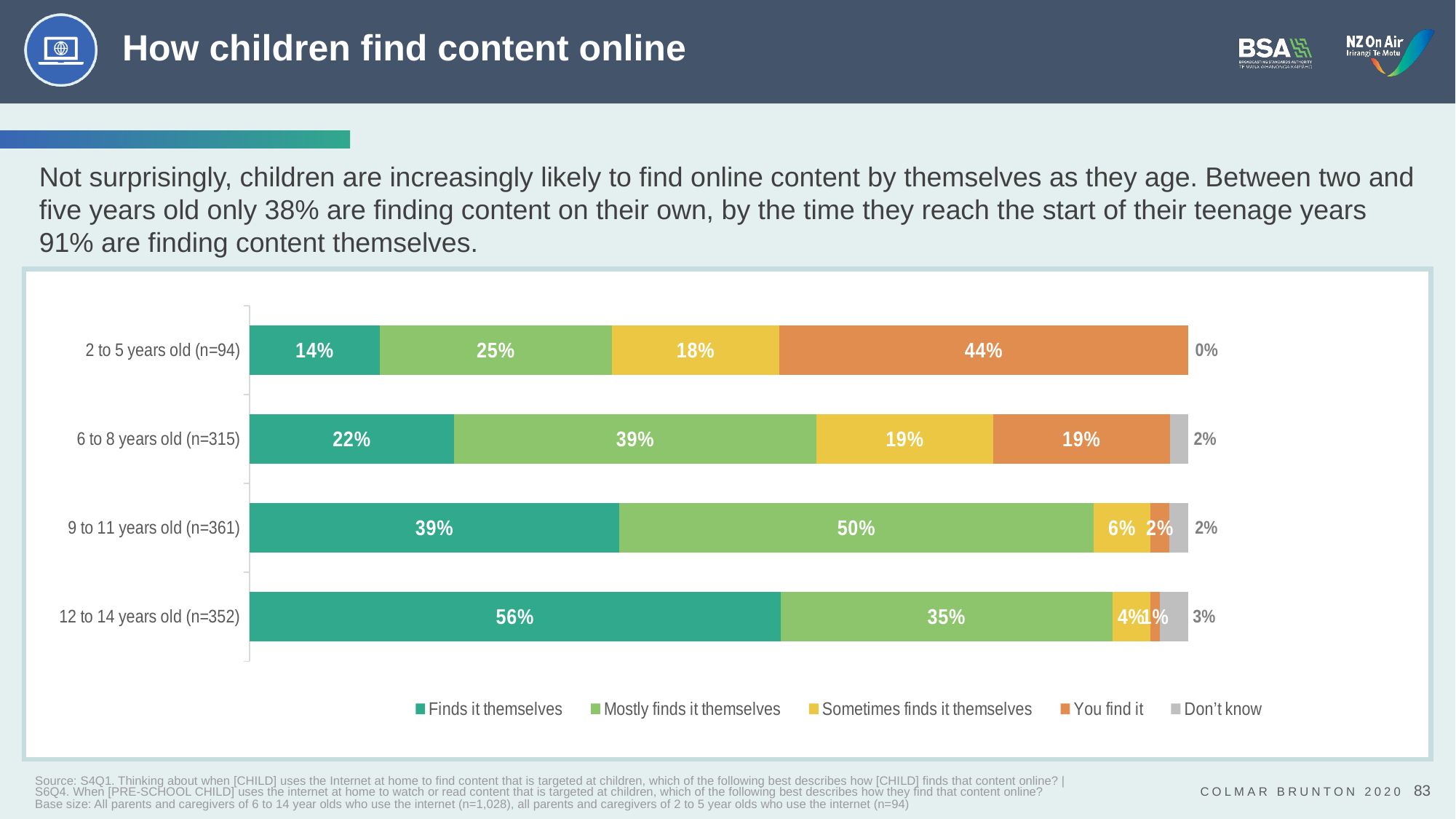
How many series does the legend list? 5 Which age group has the lowest "You find it" percentage? 12 to 14 years old (n=352) What is the combined total of "Finds it themselves" and "Mostly finds it themselves" for 9 to 11 year olds? 89% What type of chart is shown on the slide? Stacked bar chart Which is larger for 6 to 8 year olds: "Finds it themselves" or "Mostly finds it themselves"? Mostly finds it themselves What is the "Mostly finds it themselves" value for 9 to 11 year olds? 50% What is the "Finds it themselves" value for 12 to 14 year olds? 56% Which age group has the highest "Finds it themselves" percentage? 12 to 14 years old (n=352) Does the "Finds it themselves" percentage rise or fall as the age groups get older? Rise What is the difference between the "Finds it themselves" values for 12 to 14 year olds and 2 to 5 year olds? 42 percentage points What percentage of 2 to 5 year olds have a parent who finds content for them ("You find it")? 44% How many age groups are shown in the chart? 4